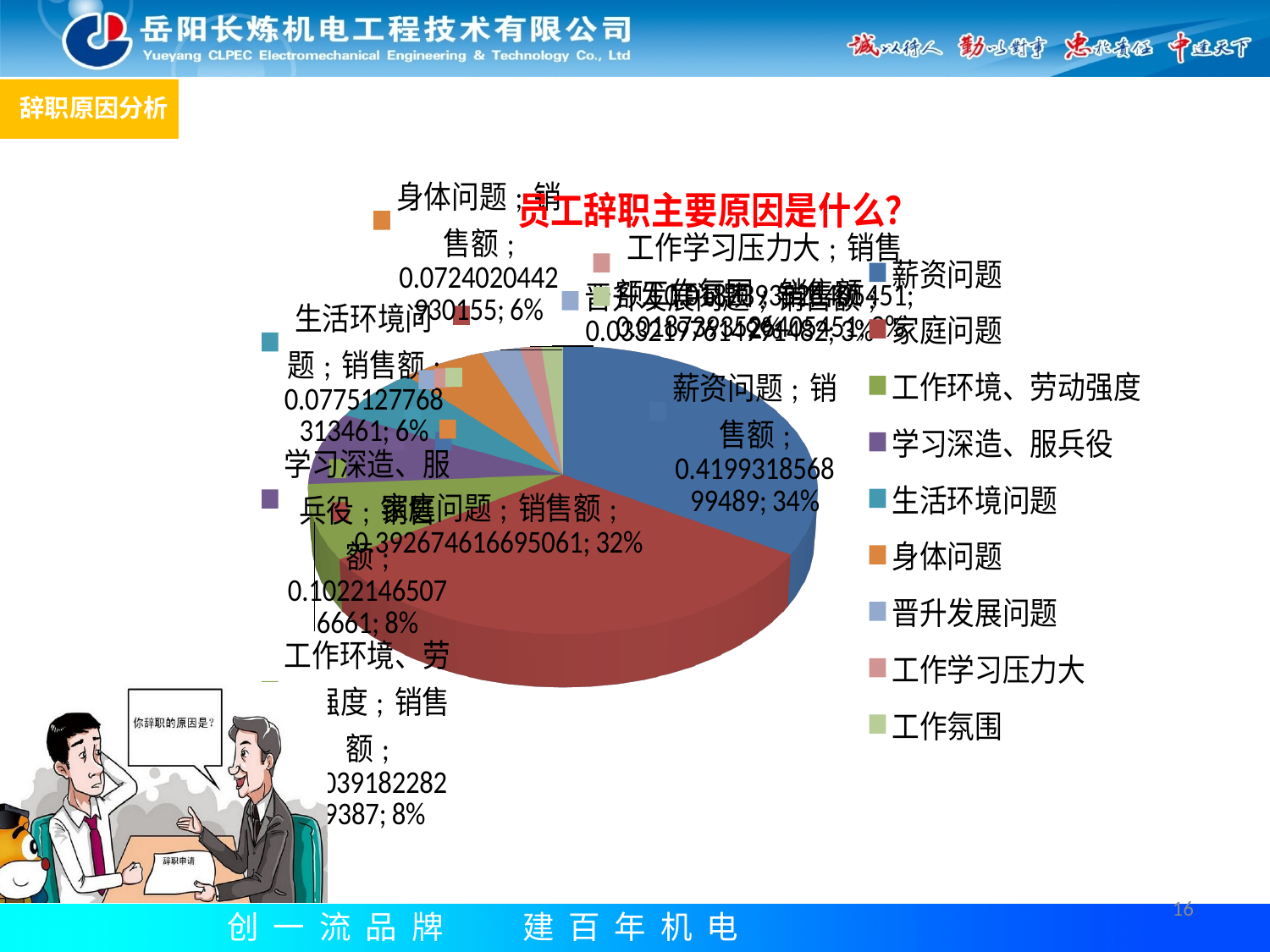
Which category has the largest share of the pie? 薪资问题 What percentage share does 生活环境问题 have in the pie chart? 6% How many categories does the legend of the pie chart list? 9 What kind of chart is shown on the slide? pie chart What percentage share does 家庭问题 have in the pie chart? 32% By how many percentage points does the share of 薪资问题 exceed that of 家庭问题? 2 Which has a larger share of the pie, 薪资问题 or 家庭问题? 薪资问题 What percentage share does 身体问题 have in the pie chart? 6% What is the title of the pie chart? 员工辞职主要原因是什么?